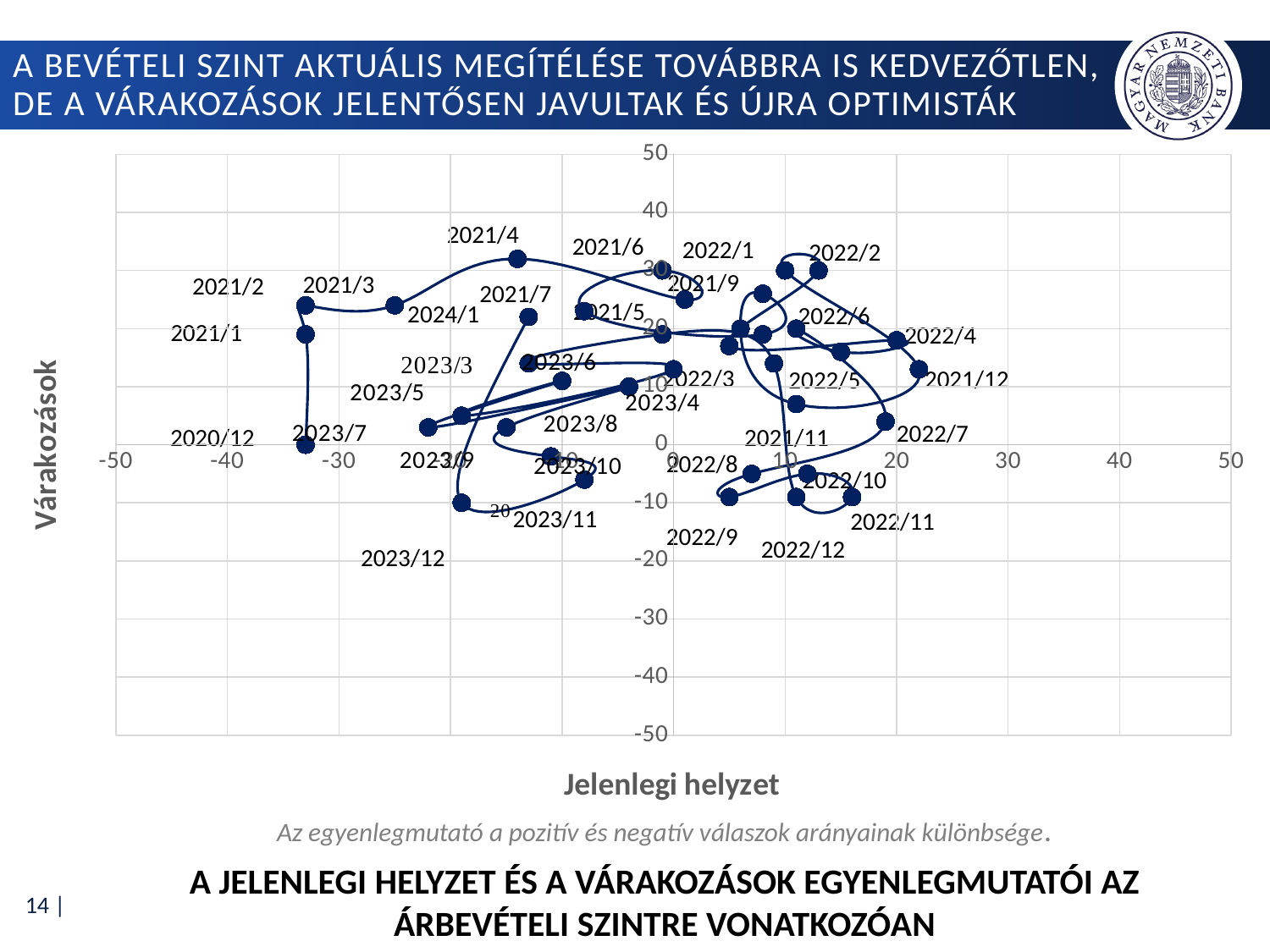
What is the title of the horizontal axis of the chart? Jelenlegi helyzet What is the title of the vertical axis of the chart? Várakozások Is the Várakozások value for 2022/11 greater or less than 0? less Is the Várakozások value for 2023/11 greater or less than 0? less Is the Várakozások value for 2021/4 greater or less than 20? greater What kind of chart is shown on the slide? scatter chart Which has the larger Jelenlegi helyzet value, 2021/2 or 2022/2? 2022/2 Which has the larger Várakozások value, 2021/4 or 2022/11? 2021/4